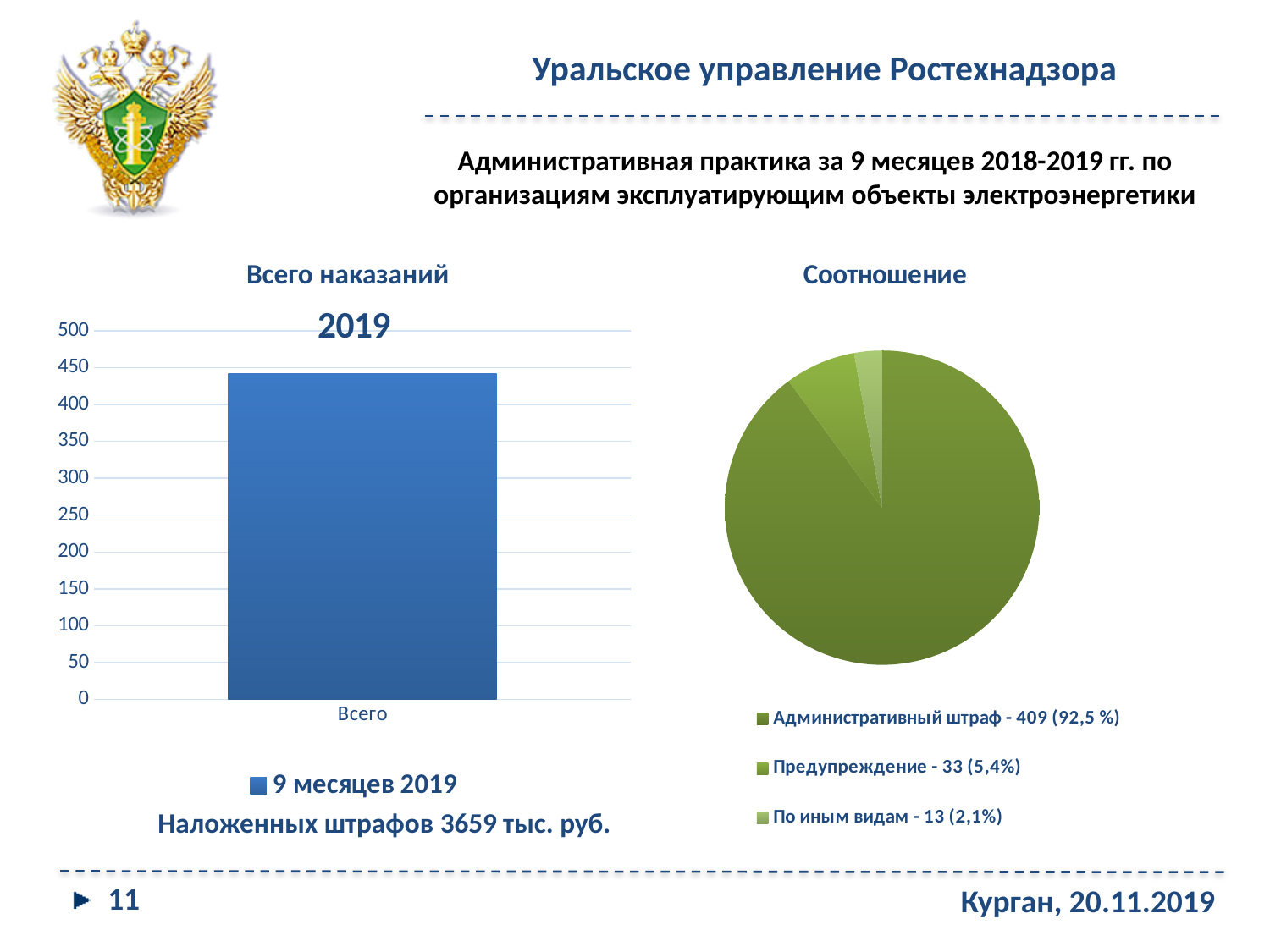
What kind of chart is the right chart titled "Соотношение"? pie chart How many slices does the pie chart "Соотношение" have? 3 In the pie chart "Соотношение", which category has the smallest slice? По иным видам In the pie chart "Соотношение", which category has the largest slice? Административный штраф In the left chart "Всего наказаний", is the value for "Всего" greater or less than 400? greater In the pie chart "Соотношение", what share does "Предупреждение" have? 5,4% How many bars are plotted in the left chart "Всего наказаний"? 1 In the pie chart "Соотношение", what is the value for "Административный штраф"? 409 What kind of chart is the left chart titled "Всего наказаний"? bar chart In the pie chart "Соотношение", what is the difference between the values for "Административный штраф" and "Предупреждение"? 376 How many series does the legend of the left chart "Всего наказаний" list? 1